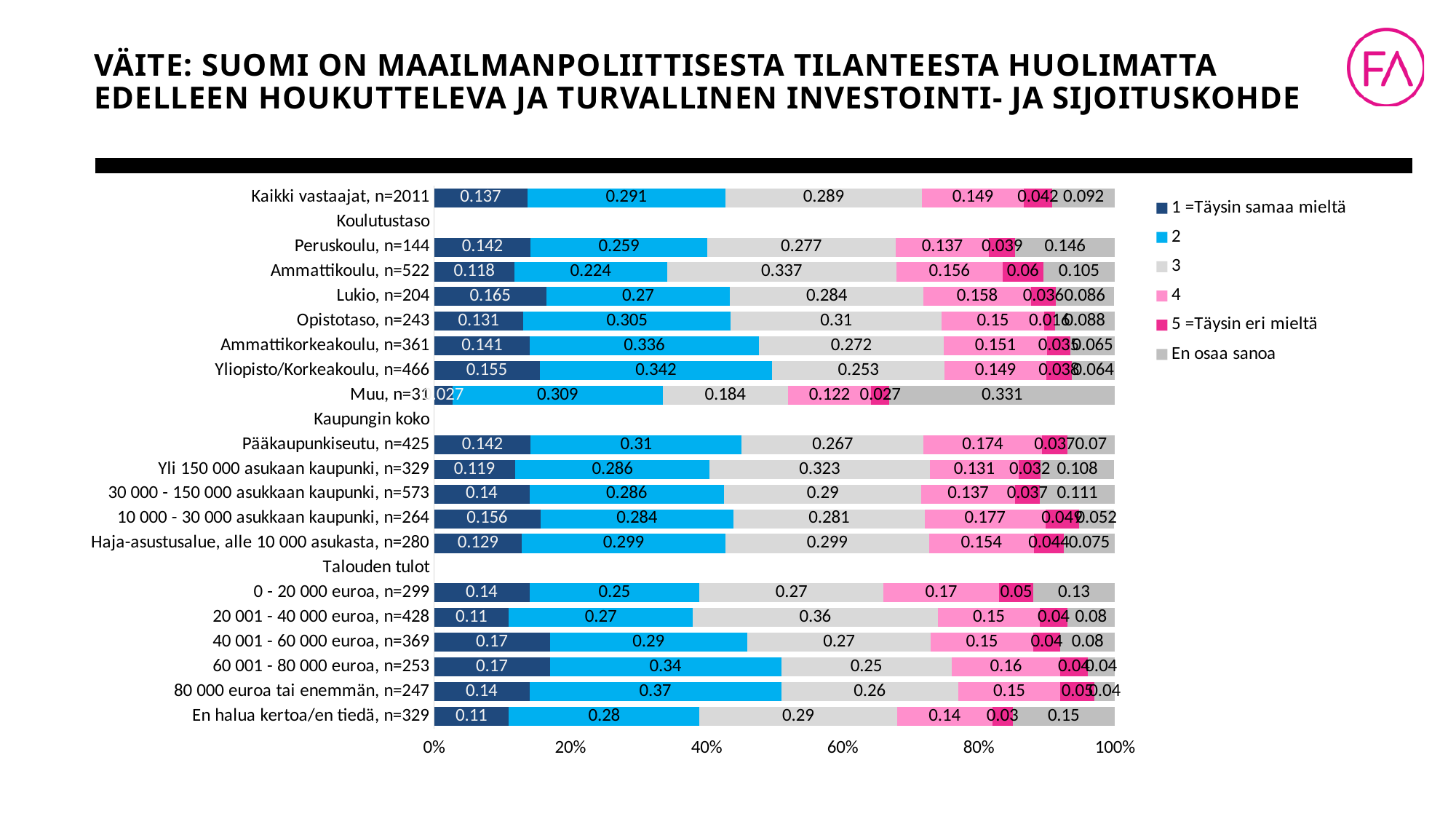
What is the value of series "1 =Täysin samaa mieltä" for "10 000 - 30 000 asukkaan kaupunki, n=264"? 0.156 What type of chart is shown on the slide? Stacked bar chart What is the difference between the series "3" values for "20 001 - 40 000 euroa, n=428" and "60 001 - 80 000 euroa, n=253"? 0.11 What is the value of series "2" for "Yliopisto/Korkeakoulu, n=466"? 0.342 What is the last entry listed in the legend? En osaa sanoa What is the "En osaa sanoa" value for "Muu, n=31"? 0.331 Which has a larger value for series "4": "Pääkaupunkiseutu, n=425" or "Yli 150 000 asukkaan kaupunki, n=329"? Pääkaupunkiseutu, n=425 How many series does the legend list? 6 Among the Talouden tulot categories, which has the highest value for series "2"? 80 000 euroa tai enemmän, n=247 Among the Koulutustaso categories, which has the highest value for series "1 =Täysin samaa mieltä"? Lukio, n=204 Among the Koulutustaso categories, which has the lowest value for series "5 =Täysin eri mieltä"? Opistotaso, n=243 What is the value of series "3" for "Kaikki vastaajat, n=2011"? 0.289